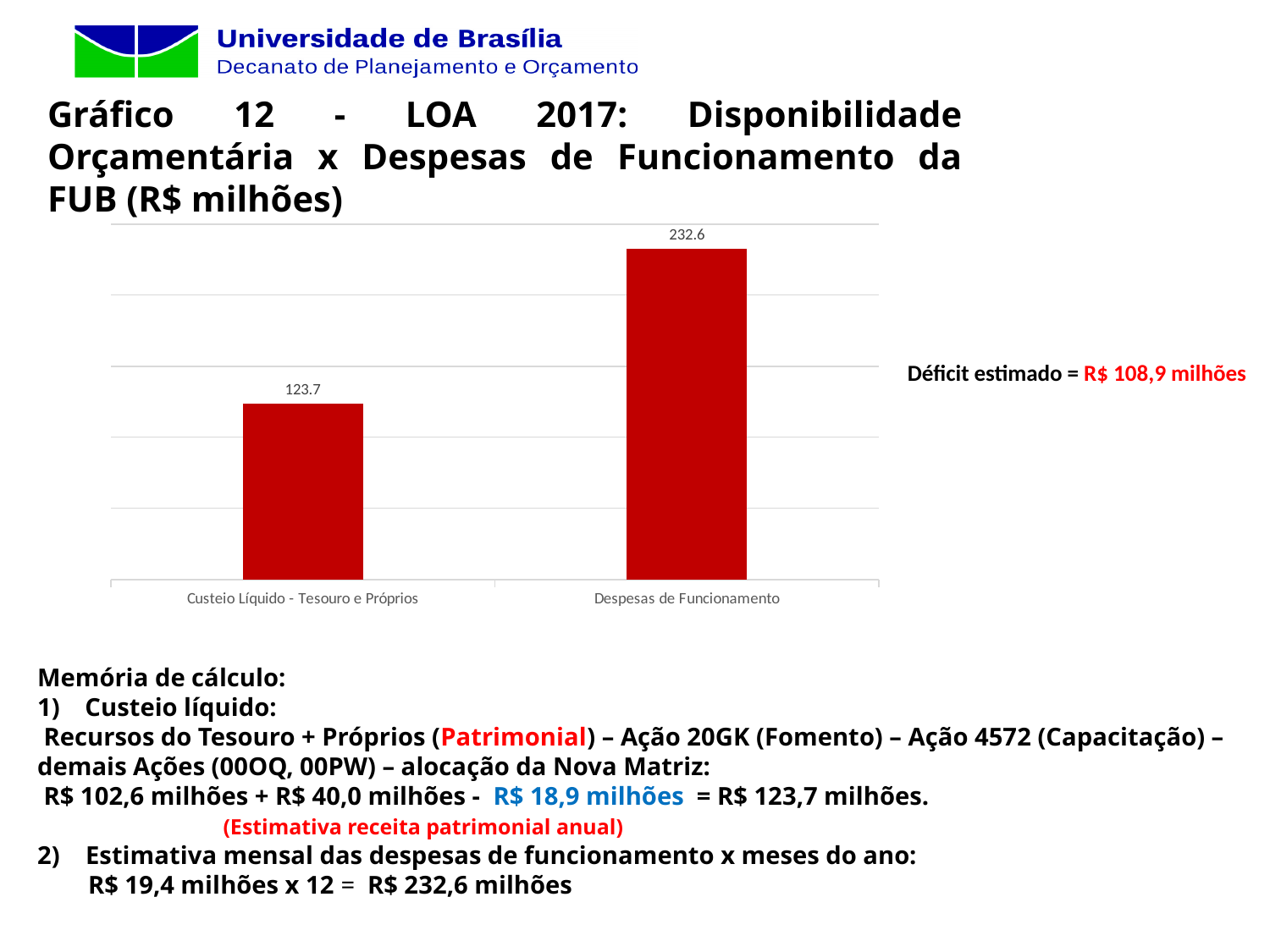
What is the value shown for Custeio Líquido - Tesouro e Próprios? 123.7 What is the label of the left-hand bar in the chart? Custeio Líquido - Tesouro e Próprios Which is larger: the value for Custeio Líquido - Tesouro e Próprios or the value for Despesas de Funcionamento? Despesas de Funcionamento How many categories are plotted in the chart? 2 Do the values rise or fall from the left bar to the right bar? Rise What colour are the bars in the chart? Red Which category has the highest value in the chart? Despesas de Funcionamento What is the value shown for Despesas de Funcionamento? 232.6 What is the difference between the value for Despesas de Funcionamento and the value for Custeio Líquido - Tesouro e Próprios? 108.9 Which category has the lowest value in the chart? Custeio Líquido - Tesouro e Próprios What kind of chart is shown on the slide? Bar chart